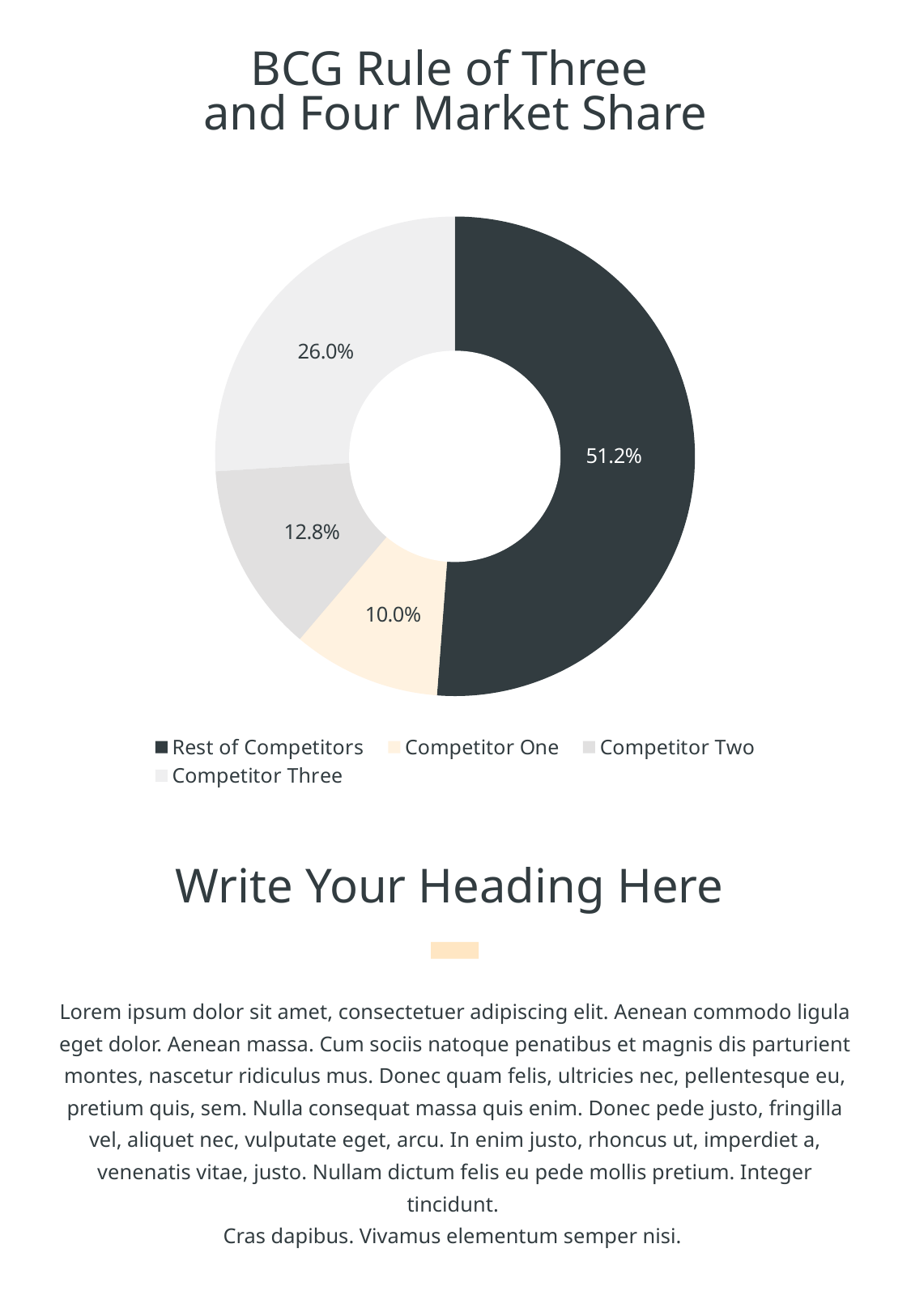
Which is larger, the share of Competitor Two or Competitor One? Competitor Two What is the title of the chart? BCG Rule of Three and Four Market Share What kind of chart is shown on the slide? Doughnut (pie) chart What share does Rest of Competitors hold in the chart? 51.2% How many slices does the chart have? 4 Which legend entry is shown in the peach colour? Competitor One What is the value shown for Competitor Two? 12.8% Which category has the largest slice? Rest of Competitors What is the difference between the shares of Competitor Three and Competitor Two? 13.2% What is the value shown for Competitor One? 10.0% Which category has the smallest slice? Competitor One What is the value shown for Competitor Three? 26.0%